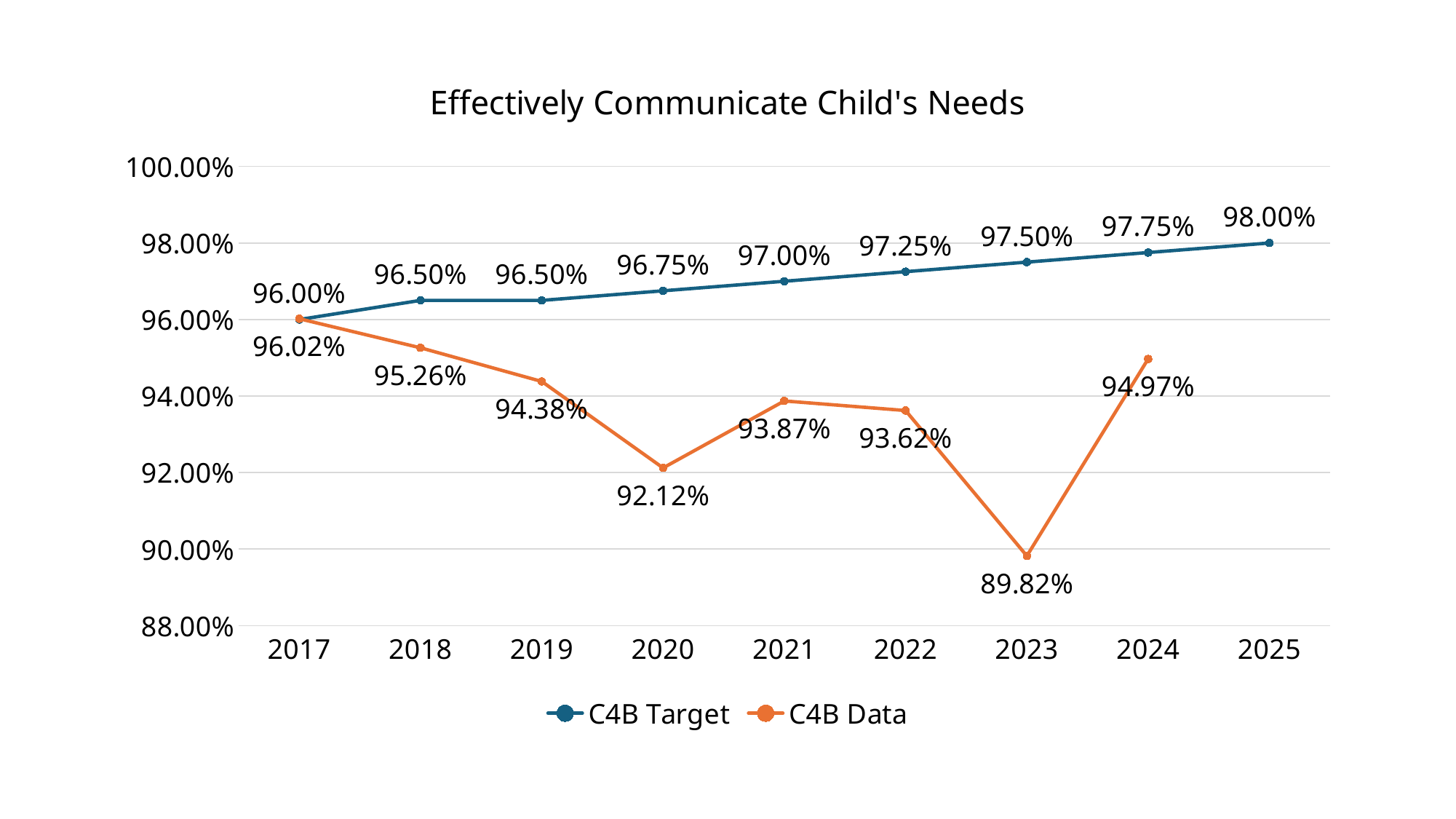
What is the C4B Data value for 2024? 94.97% What kind of chart is this? Line chart Which is larger in 2017, the C4B Target or the C4B Data value? C4B Data In which year is the C4B Target value highest? 2025 What is the C4B Target value for 2021? 97.00% Is the C4B Data value for 2020 greater or less than 92.00%? greater In which year is the C4B Data value lowest? 2023 What is the C4B Data value for 2023? 89.82% How many series does the legend list? 2 How many years are shown on the x axis? 9 Does the C4B Target series rise or fall from 2017 to 2025? Rise What is the difference between the C4B Target and C4B Data values in 2023? 7.68%